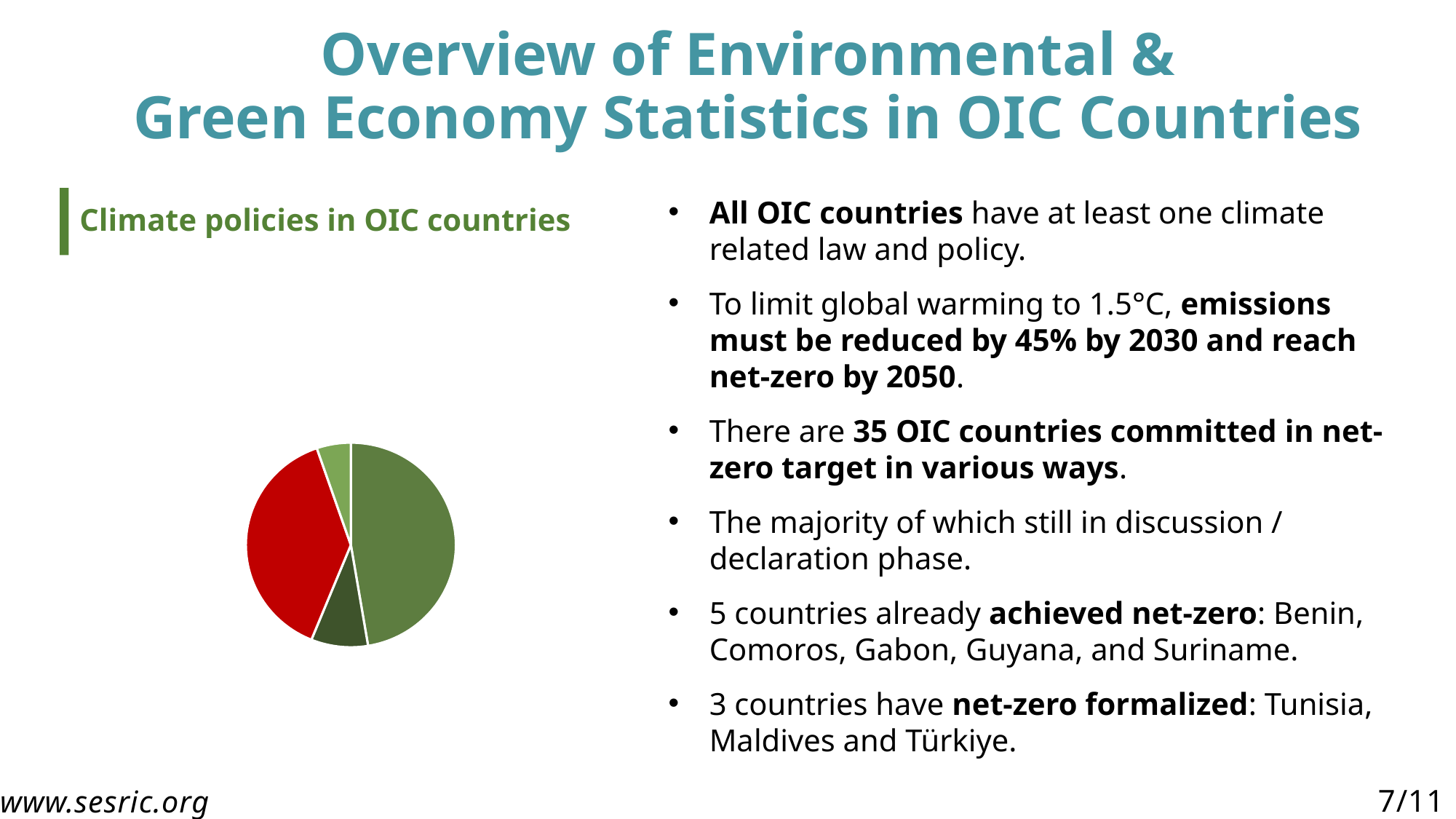
How many slices does the pie chart have? 4 Which colour slice is the largest in the pie chart? green Which colour slice is the smallest in the pie chart? light green Does the pie chart show a legend? No Is the red slice larger or smaller than the dark green slice? larger What kind of chart is shown on the slide? pie chart